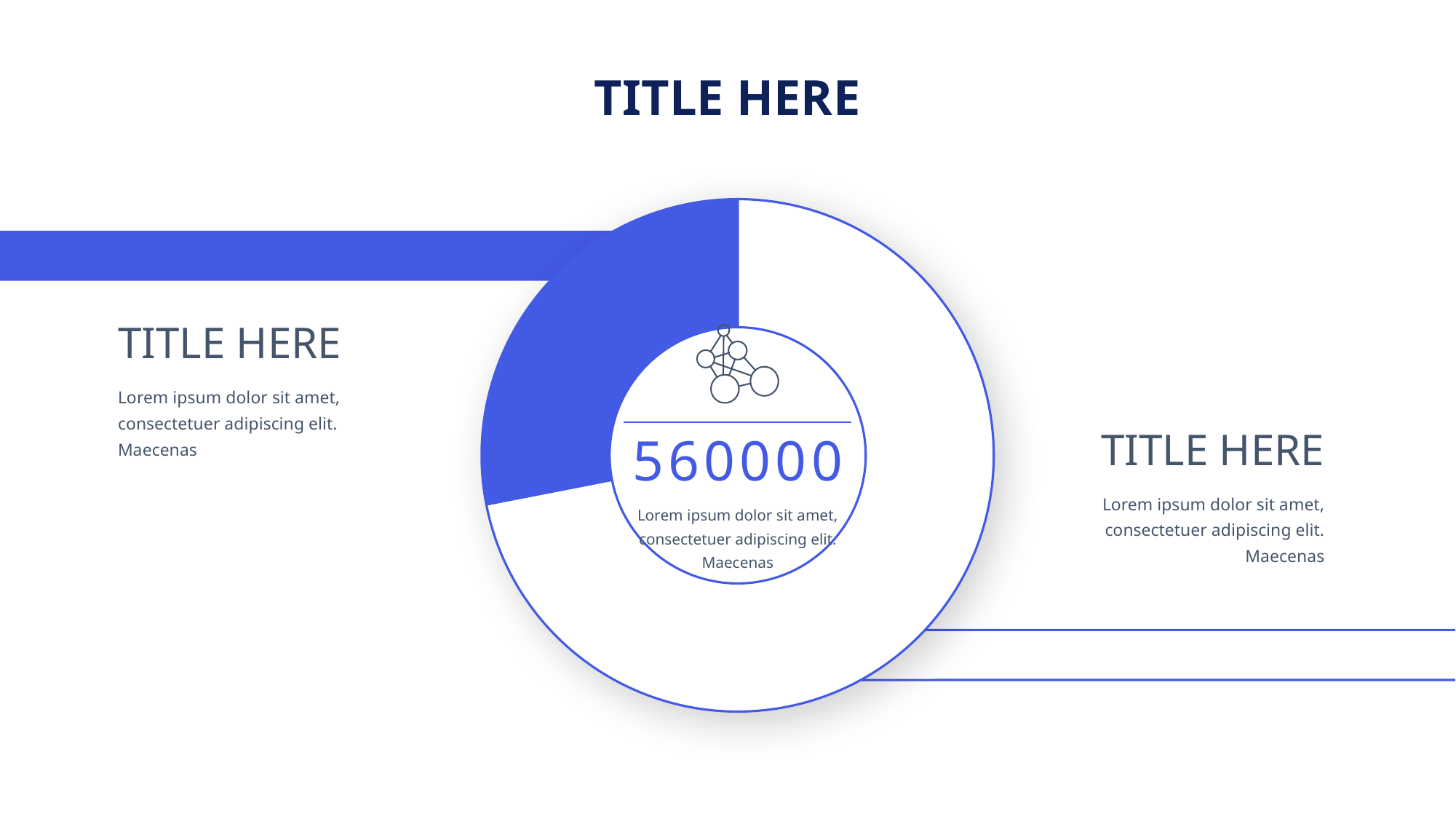
What is the title shown above the doughnut chart? TITLE HERE Is the blue slice of the doughnut chart more or less than half of the chart? less What kind of chart is shown on the slide? doughnut chart Which slice of the doughnut chart is larger, the blue slice or the white slice? the white slice How many slices does the doughnut chart have? 2 What number is printed in the centre of the doughnut chart? 560000 Which slice of the doughnut chart is the smallest? the blue slice